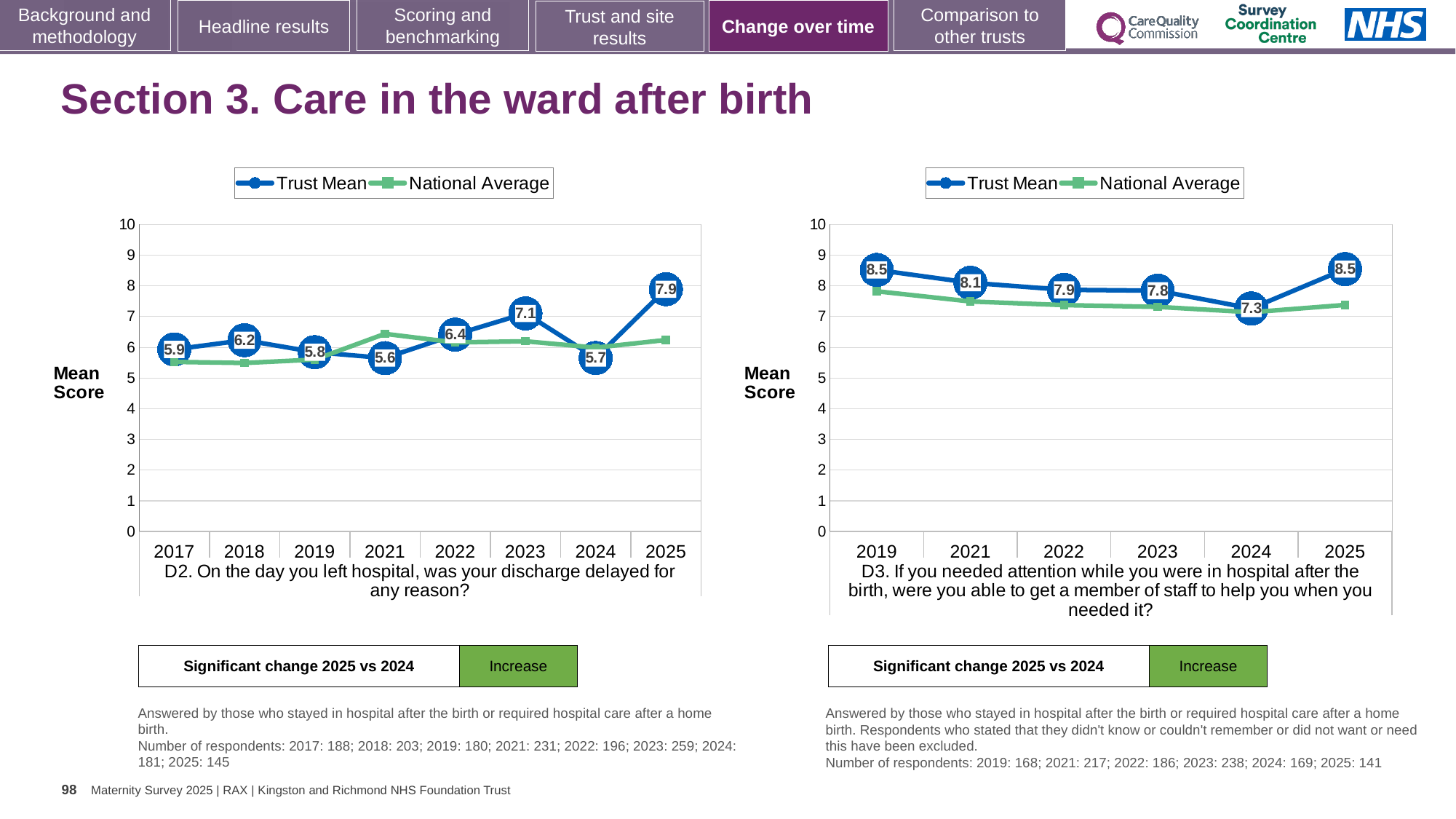
In the D2 chart on the left, how many years are shown on the x axis? 8 How many series does the legend of the D3 chart on the right list? 2 In the D2 chart on the left, what is the Trust Mean for 2021? 5.6 In the D2 chart on the left, what is the Trust Mean for 2025? 7.9 In the D2 chart on the left, which year has the lowest Trust Mean? 2021 In the D2 chart on the left, which year has the highest Trust Mean? 2025 In the D3 chart on the right, is the National Average for 2019 greater or less than 7? greater In the D2 chart on the left, what is the difference between the Trust Mean for 2025 and 2024? 2.2 In the D3 chart on the right, does the Trust Mean rise or fall from 2019 to 2024? fall In the D3 chart on the right, is the Trust Mean for 2021 larger or smaller than the Trust Mean for 2023? larger In the D3 chart on the right, what is the Trust Mean for 2024? 7.3 In the D3 chart on the right, which year has the lowest Trust Mean? 2024